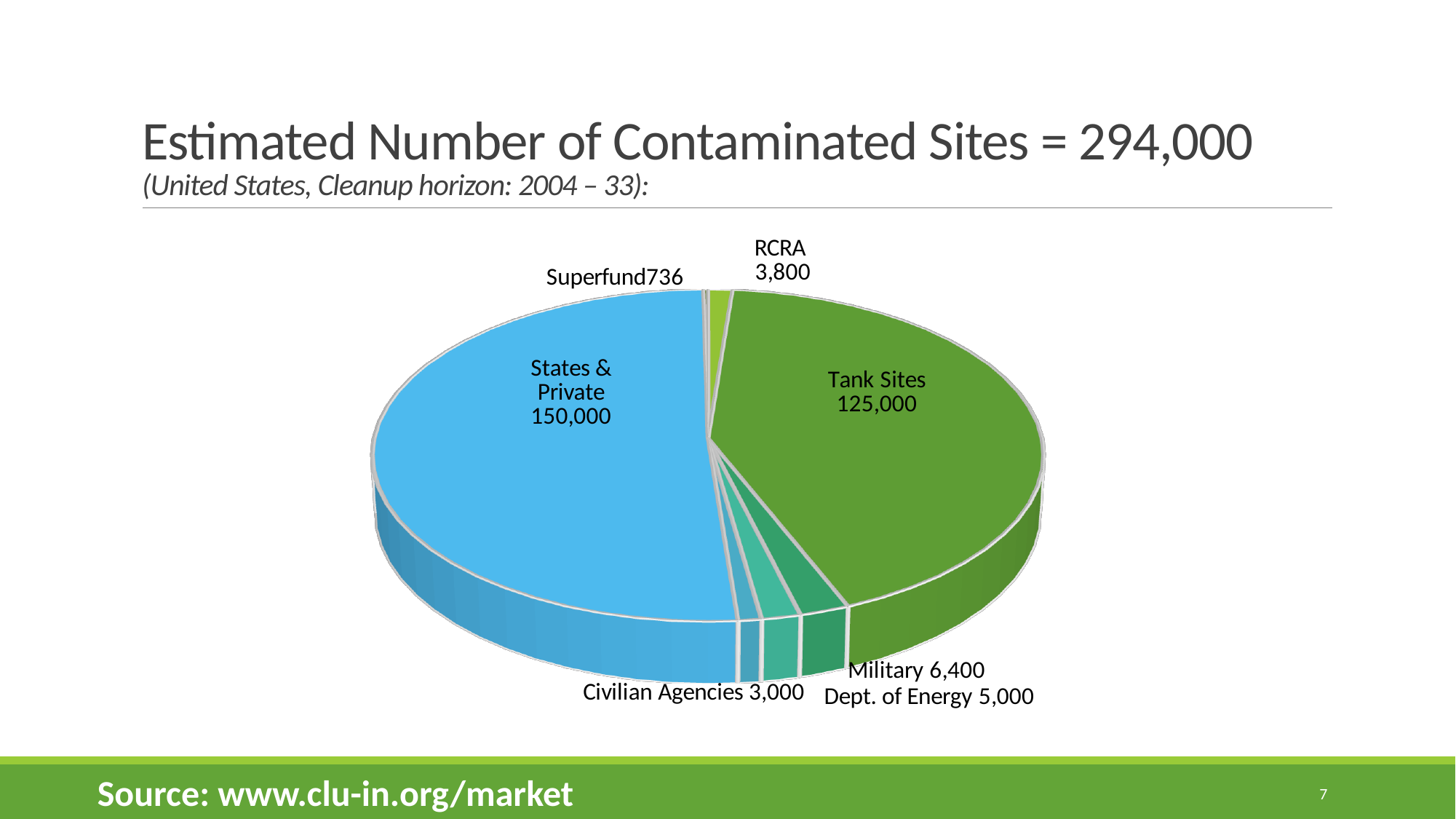
What is the value shown for Military? 6,400 How many slices does the pie chart have? 7 What kind of chart is shown on the slide? Pie chart What is the difference between the Military value and the Dept. of Energy value? 1,400 Which category has the largest slice of the pie? States & Private Which is larger, the value for Military or the value for Civilian Agencies? Military Which category has the smallest slice of the pie? Superfund What is the value shown for RCRA? 3,800 What is the value shown for Tank Sites? 125,000 What is the difference between the States & Private value and the Tank Sites value? 25,000 According to the slide title, what is the estimated total number of contaminated sites? 294,000 What is the estimated number of contaminated sites for States & Private? 150,000